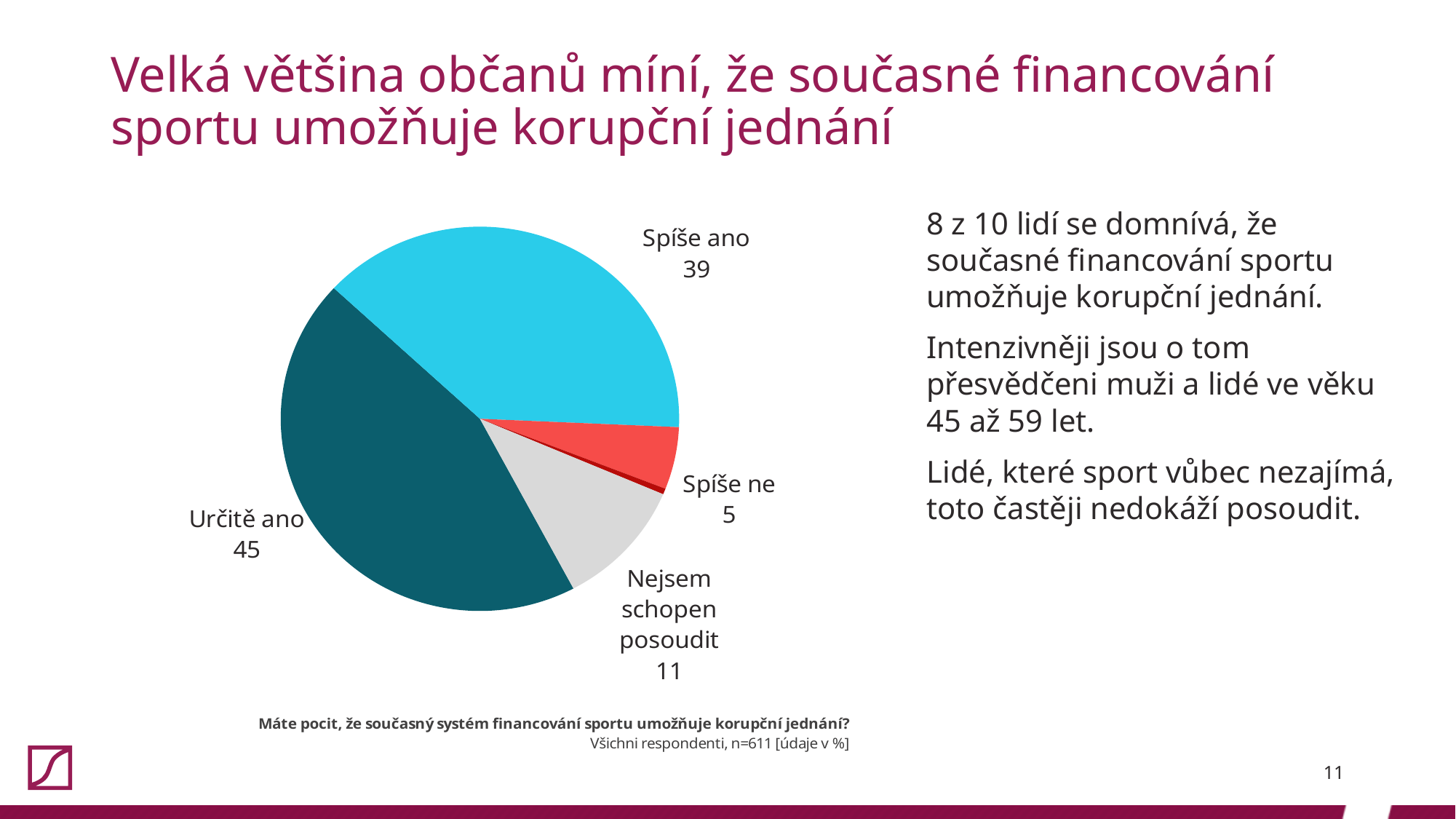
What is the difference between the values for "Nejsem schopen posoudit" and "Spíše ne"? 6 According to the note below the chart, how many respondents (n) does the chart cover? 611 Which is larger, the value for "Spíše ano" or the value for "Nejsem schopen posoudit"? Spíše ano Which labelled slice of the pie chart has the smallest value? Spíše ne What kind of chart is shown on the slide? Pie chart Which labelled slice of the pie chart has the largest value? Určitě ano What is the difference between the values for "Určitě ano" and "Spíše ano"? 6 What colour is the "Určitě ano" slice of the pie chart? Dark teal What value is shown for the "Spíše ano" slice of the pie chart? 39 What value is shown for the "Spíše ne" slice of the pie chart? 5 What value is shown for the "Nejsem schopen posoudit" slice of the pie chart? 11 What value is shown for the "Určitě ano" slice of the pie chart? 45